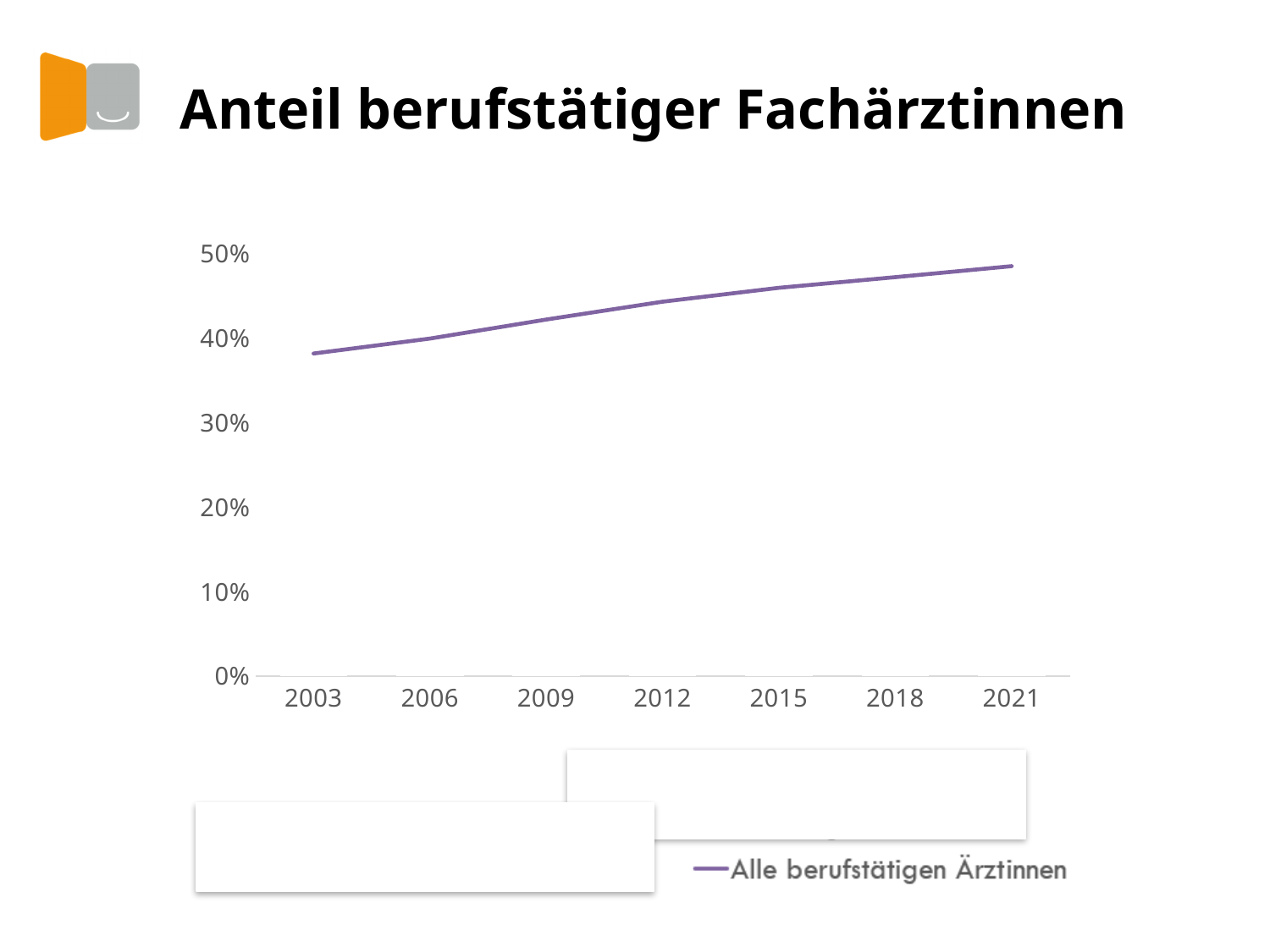
What kind of chart is shown on the slide? line chart How many year labels are shown on the x axis? 7 Which is larger, the value for Alle berufstätigen Ärztinnen in 2009 or in 2018? 2018 Is the value for Alle berufstätigen Ärztinnen in 2003 greater or less than 40%? less Is the value for Alle berufstätigen Ärztinnen in 2003 greater or less than 30%? greater Does the line for Alle berufstätigen Ärztinnen rise or fall from 2003 to 2021? rise Is the value for Alle berufstätigen Ärztinnen in 2021 greater or less than 40%? greater In which year is the value for Alle berufstätigen Ärztinnen highest? 2021 What is the title of the chart? Anteil berufstätiger Fachärztinnen In which year is the value for Alle berufstätigen Ärztinnen lowest? 2003